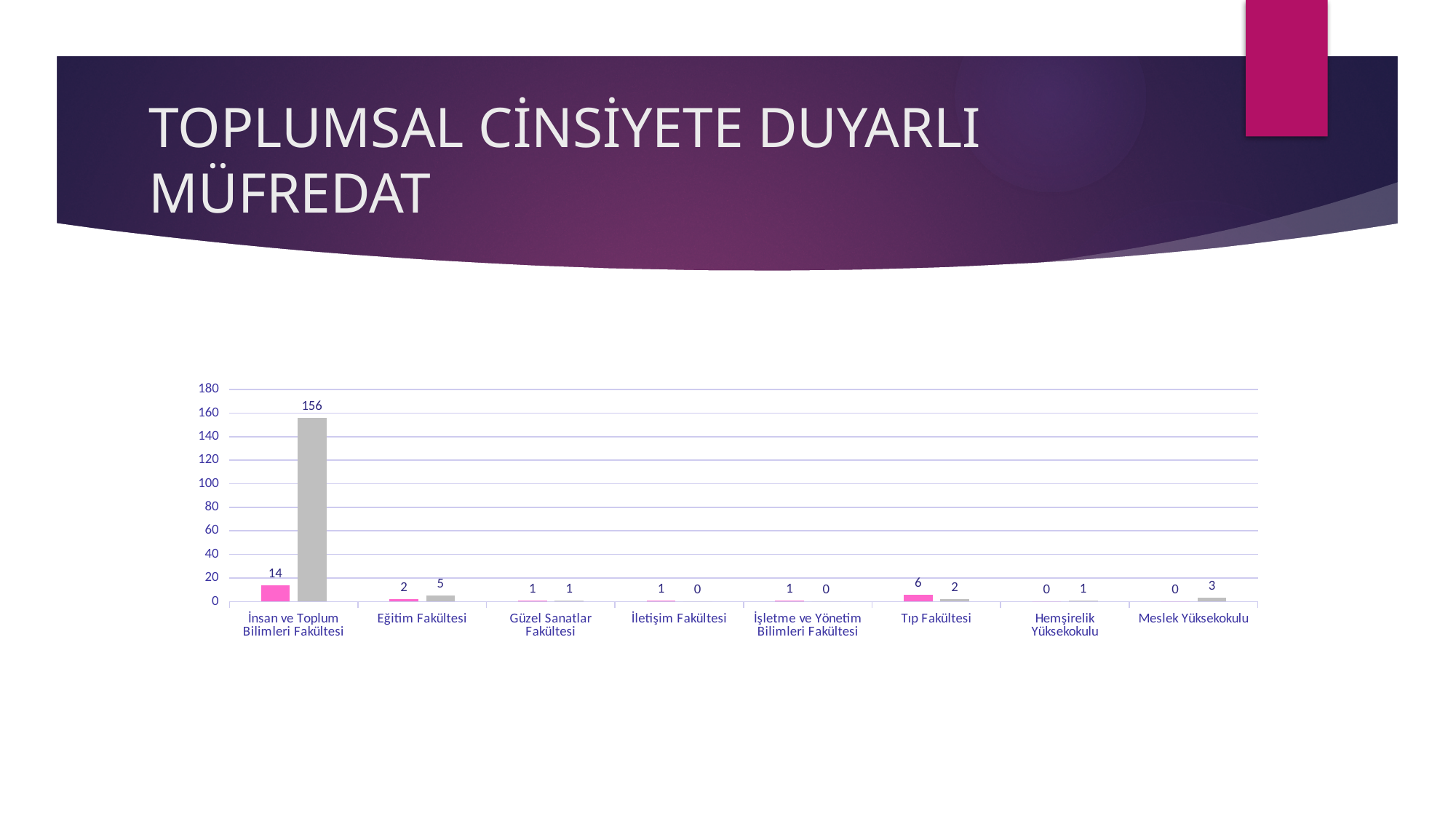
What is the difference between the grey bar and the pink bar for Eğitim Fakültesi? 3 What is the value of the grey bar for Meslek Yüksekokulu? 3 What is the value of the grey bar for İnsan ve Toplum Bilimleri Fakültesi? 156 What is the difference between the grey bar and the pink bar for İnsan ve Toplum Bilimleri Fakültesi? 142 How many categories (faculties/schools) are shown on the x axis of the chart? 8 What is the value of the pink bar for Tıp Fakültesi? 6 What type of chart is shown on the slide? bar chart Is the grey bar for İnsan ve Toplum Bilimleri Fakültesi greater or less than 140? greater What is the value of the pink bar for İnsan ve Toplum Bilimleri Fakültesi? 14 Which is larger for Tıp Fakültesi, the pink bar or the grey bar? the pink bar Which category has the highest grey bar? İnsan ve Toplum Bilimleri Fakültesi What is the highest value shown on the y axis of the chart? 180